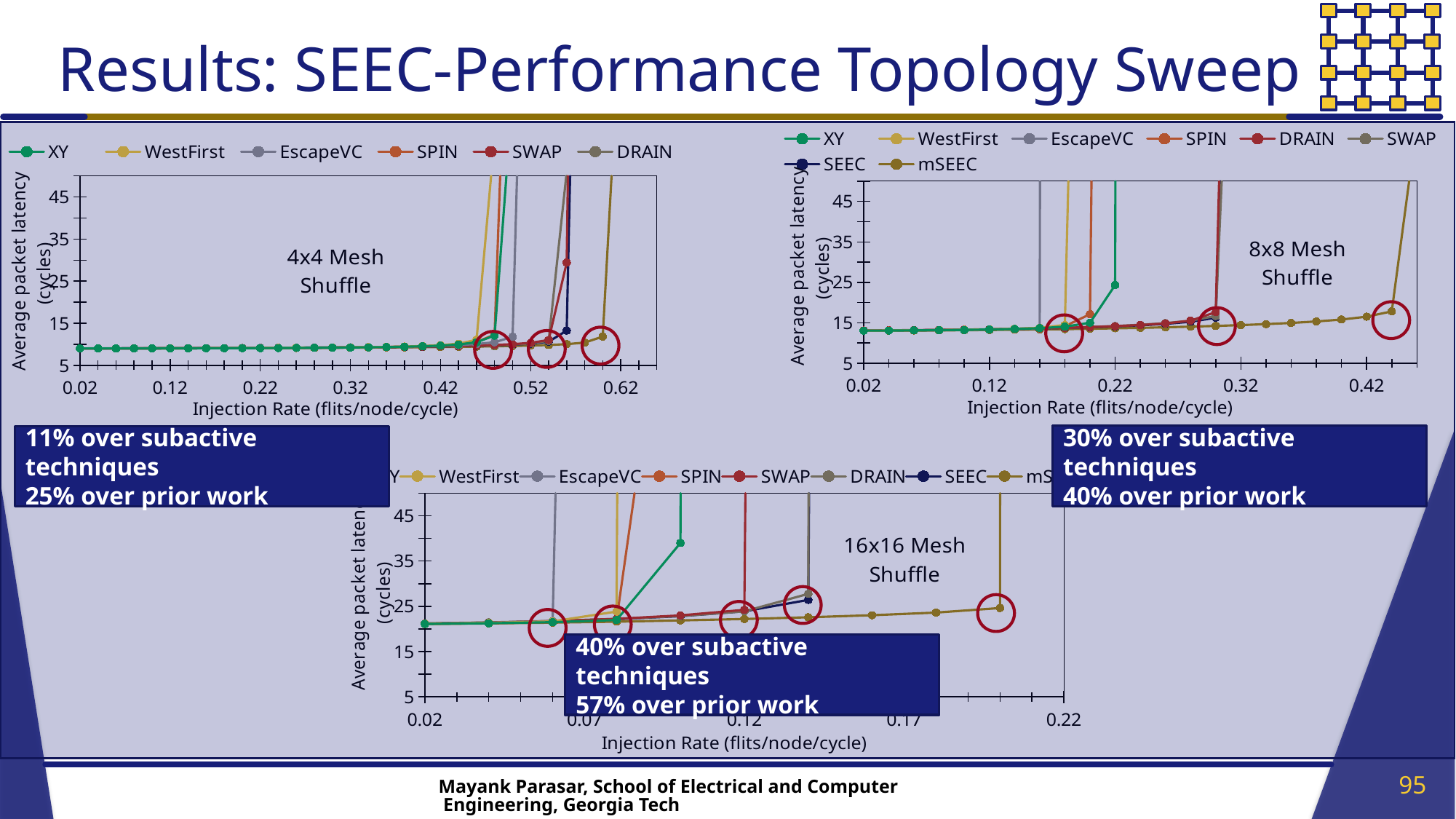
In the 16x16 Mesh Shuffle chart, which series sustains the highest injection rate before its latency spikes? mSEEC In the 8x8 Mesh Shuffle chart, which series sustains the highest injection rate before its latency spikes? mSEEC What is the largest injection rate tick shown on the x axis of the 16x16 Mesh Shuffle chart? 0.22 How many series does the legend of the 8x8 Mesh Shuffle chart list? 8 In the 16x16 Mesh Shuffle chart, is the average packet latency at injection rate 0.02 greater or less than 25? less What is the x-axis label of the 4x4 Mesh Shuffle chart? Injection Rate (flits/node/cycle) How many charts are shown on the slide? 3 In the 16x16 Mesh Shuffle chart, does average packet latency rise or fall as injection rate increases? rise In the 8x8 Mesh Shuffle chart, which series saturates at the lowest injection rate? EscapeVC In the 16x16 Mesh Shuffle chart, is the average packet latency at injection rate 0.02 greater or less than 15? greater In the 4x4 Mesh Shuffle chart, is the average packet latency at injection rate 0.02 greater or less than 15? less What kind of chart is the 8x8 Mesh Shuffle chart? line chart